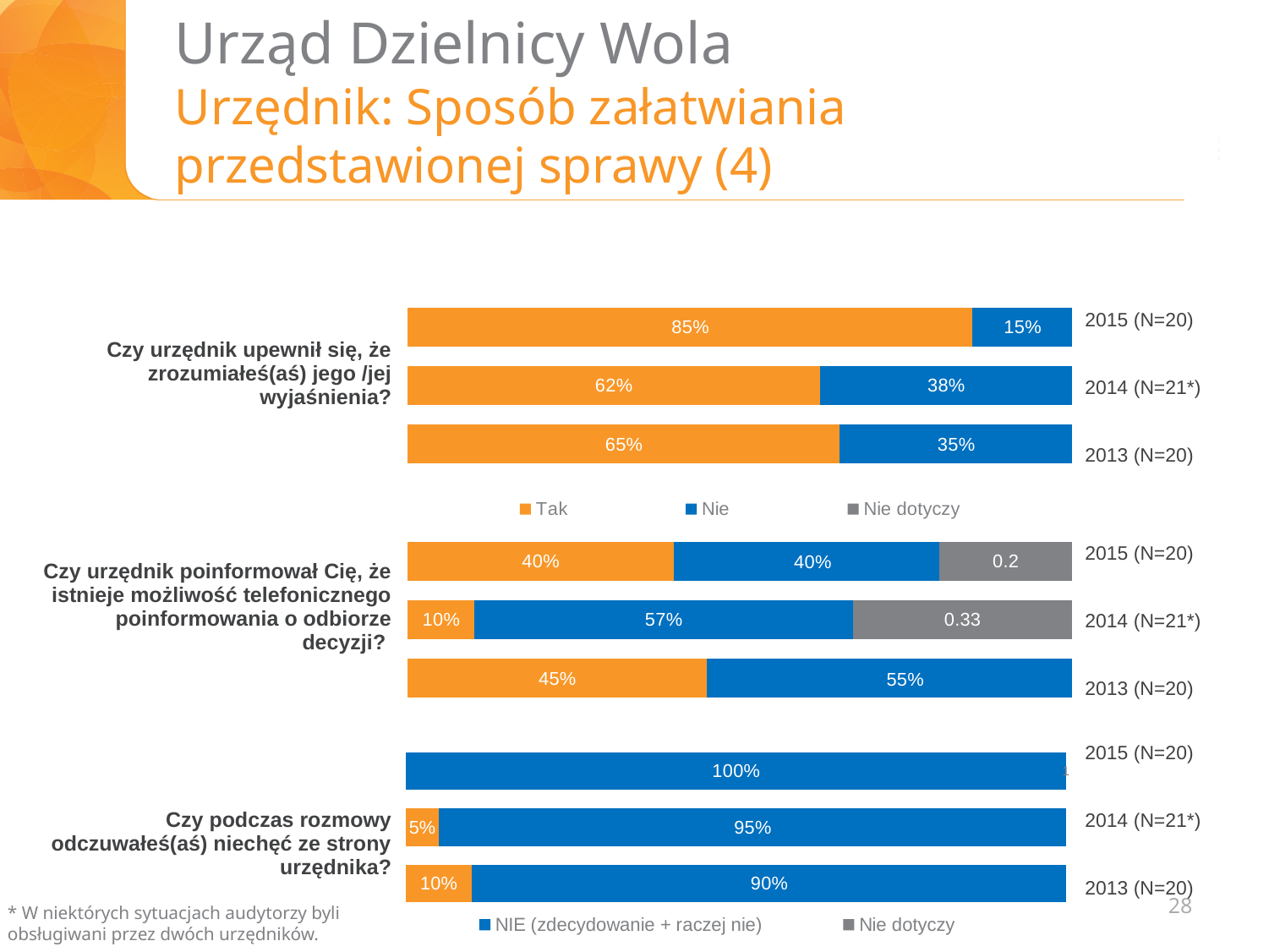
In the top chart ("Czy urzędnik upewnił się, że zrozumiałeś(aś) jego /jej wyjaśnienia?"), what is the "Tak" value for 2015 (N=20)? 85% In the middle chart ("Czy urzędnik poinformował Cię..."), which year has the lowest "Tak" share? 2014 (N=21*) In the top chart ("Czy urzędnik upewnił się..."), which year has the highest "Tak" share? 2015 (N=20) In the middle chart ("Czy urzędnik poinformował Cię..."), what is the "Nie dotyczy" value for 2015 (N=20)? 0.2 In the middle chart ("Czy urzędnik poinformował Cię..."), is the "Tak" value for 2013 larger or smaller than the "Nie" value for 2013? smaller In the bottom chart ("Czy podczas rozmowy odczuwałeś(aś) niechęć..."), what is the difference between the "NIE" values for 2015 and 2013? 10% In the top chart ("Czy urzędnik upewnił się..."), what is the difference between the "Tak" values for 2013 and 2014? 3% In the top chart ("Czy urzędnik upewnił się..."), what is the "Nie" value for 2014 (N=21*)? 38% In the middle chart ("Czy urzędnik poinformował Cię, że istnieje możliwość telefonicznego poinformowania o odbiorze decyzji?"), what is the "Nie" value for 2014 (N=21*)? 57% What type of chart is used on this slide? Stacked bar chart How many series does the legend of the top chart list? 3 In the bottom chart ("Czy podczas rozmowy odczuwałeś(aś) niechęć ze strony urzędnika?"), what is the "NIE (zdecydowanie + raczej nie)" value for 2015 (N=20)? 100%